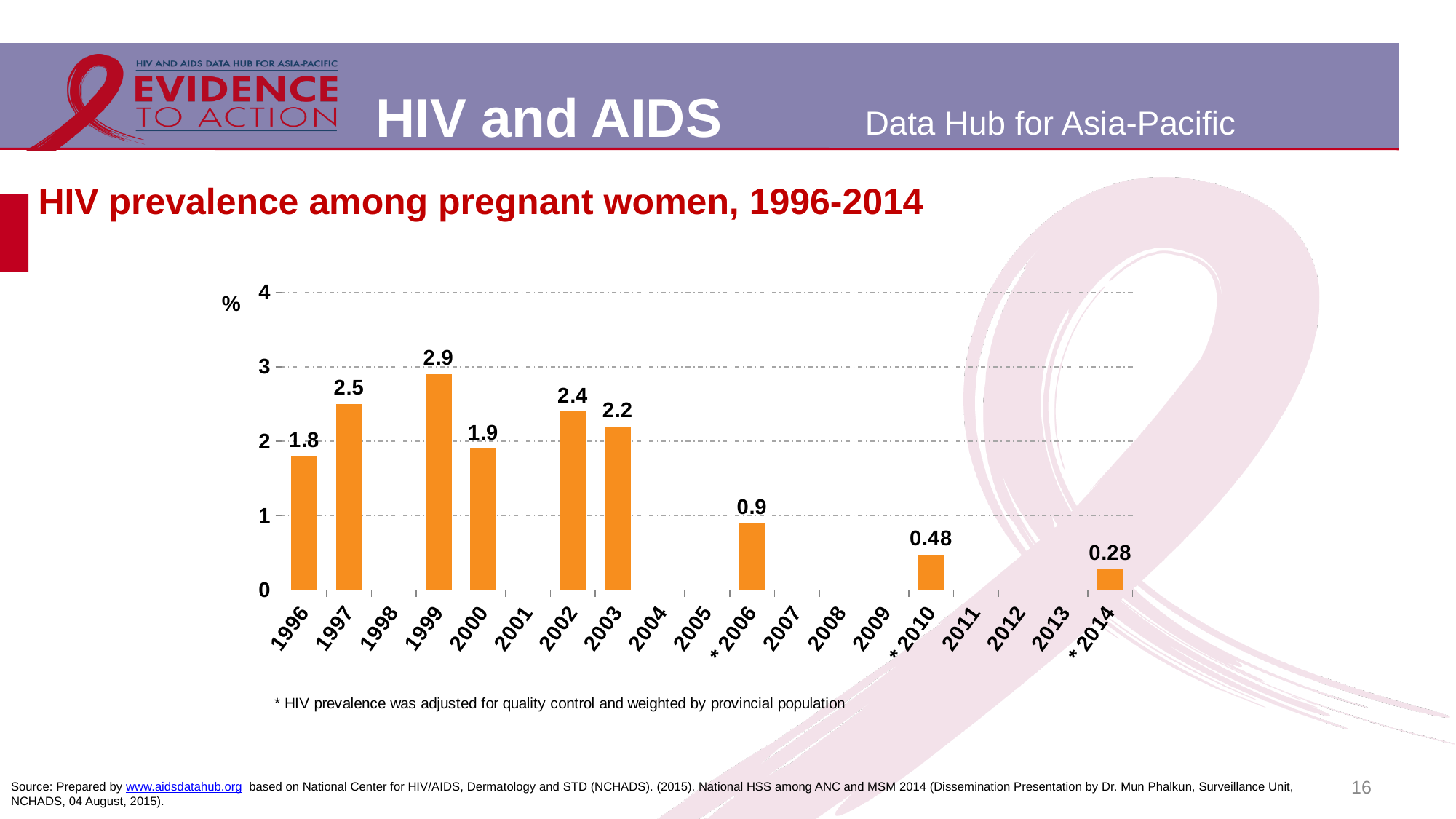
What is the difference in HIV prevalence between 1999 and 2014? 2.62 How many years have a bar plotted on the chart? 9 What is the HIV prevalence among pregnant women in 2006? 0.9 Which year has the lowest HIV prevalence among pregnant women? 2014 Which year has a higher HIV prevalence, 2002 or 2003? 2002 Which year has the highest HIV prevalence among pregnant women? 1999 What is the HIV prevalence among pregnant women in 2014? 0.28 What is the difference in HIV prevalence between 1997 and 1996? 0.7 Does HIV prevalence among pregnant women generally rise or fall from 1999 to 2014? fall Is the HIV prevalence for 2010 greater or less than 1? less What kind of chart is shown on the slide? bar chart What is the HIV prevalence among pregnant women in 1999? 2.9